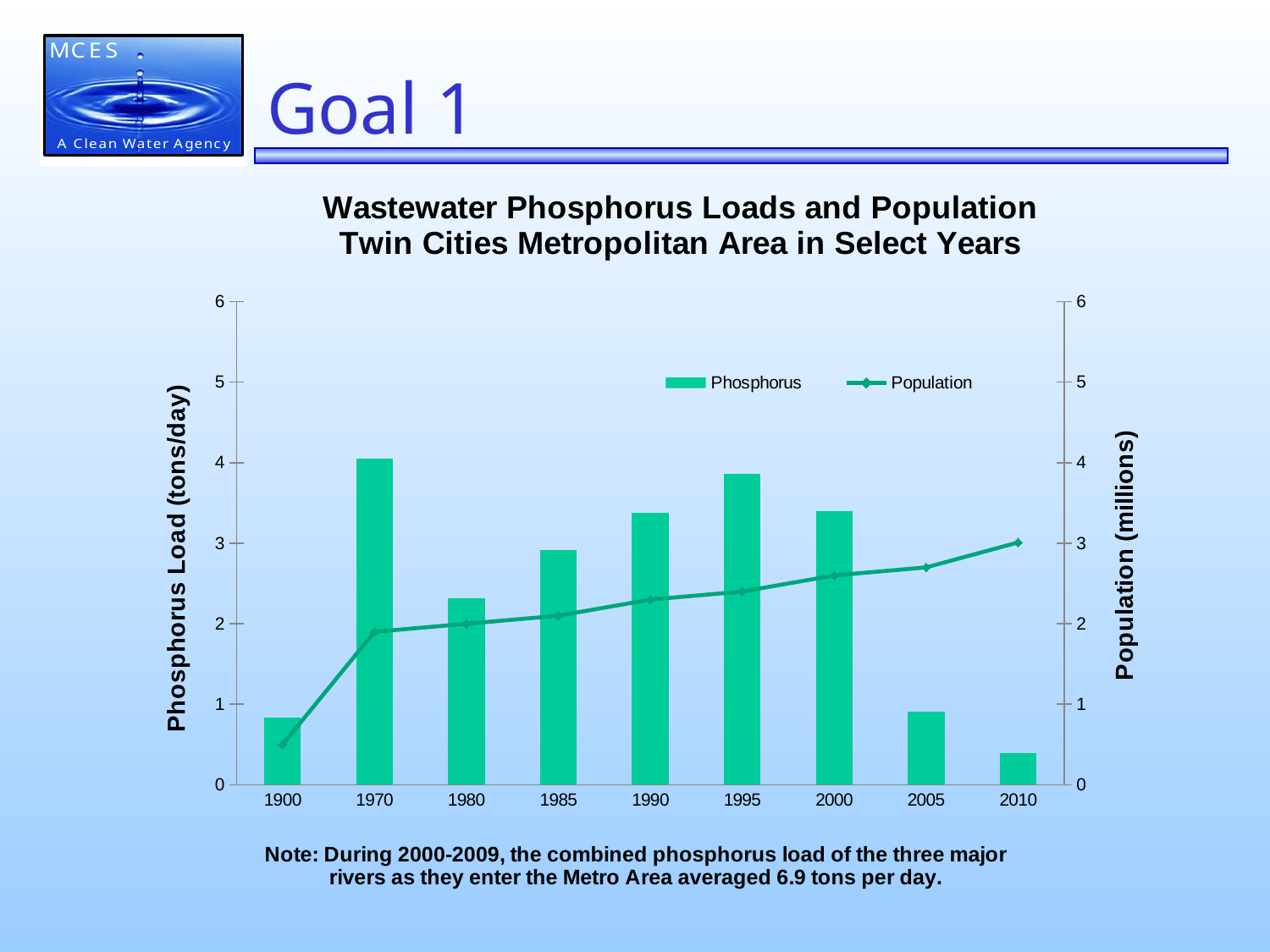
Is the population for 1900 greater or less than 1 million? less What kind of chart is shown on the slide? A bar chart combined with a line chart How many series does the legend list? 2 Which year has the lowest phosphorus load? 2010 Which year has the highest phosphorus load? 1970 Is the phosphorus load for 2005 greater or less than 1 ton/day? less Does the population line rise or fall from 1900 to 2010? Rises How many years are shown on the x axis? 9 What is the label of the right-hand vertical axis? Population (millions) Is the phosphorus load for 1970 greater or less than 4 tons/day? greater Which is larger, the phosphorus load in 1985 or in 1990? 1990